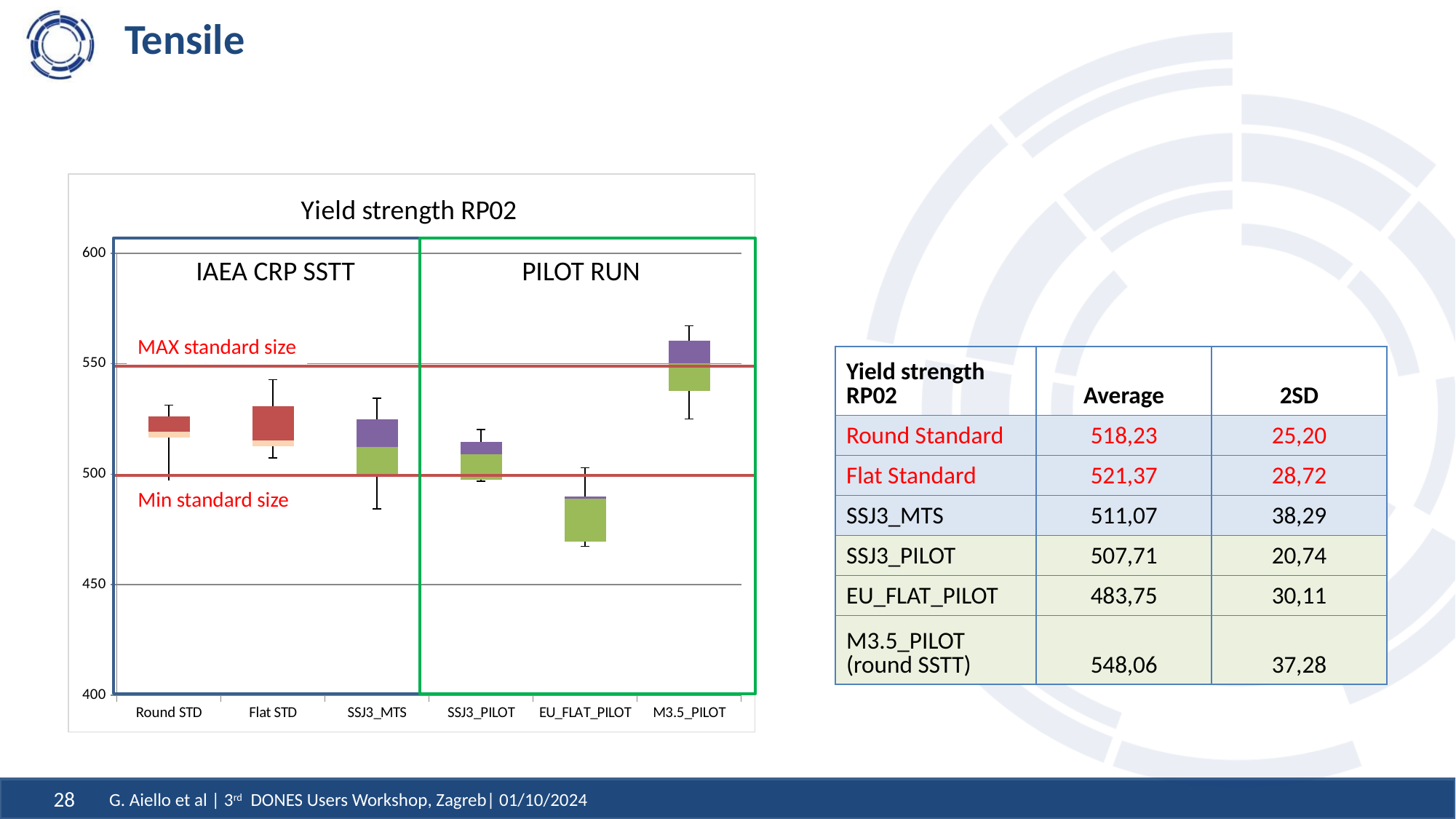
Is the top whisker of M3.5_PILOT greater or less than 550? greater How many categories are in the PILOT RUN group of the chart? 3 What kind of chart is shown on the slide? box plot (box-and-whisker chart) Which category has the lowest yield strength values in the chart? EU_FLAT_PILOT Which category has the highest yield strength values in the chart? M3.5_PILOT Is the box for Round STD greater or less than 550? less Which has higher yield strength values, Round STD or EU_FLAT_PILOT? Round STD Is the box for EU_FLAT_PILOT greater or less than 500? less How many categories are shown on the x axis of the chart? 6 What is the title of the chart? Yield strength RP02 Which has higher yield strength values, M3.5_PILOT or EU_FLAT_PILOT? M3.5_PILOT What are the two group labels written inside the chart area? IAEA CRP SSTT and PILOT RUN